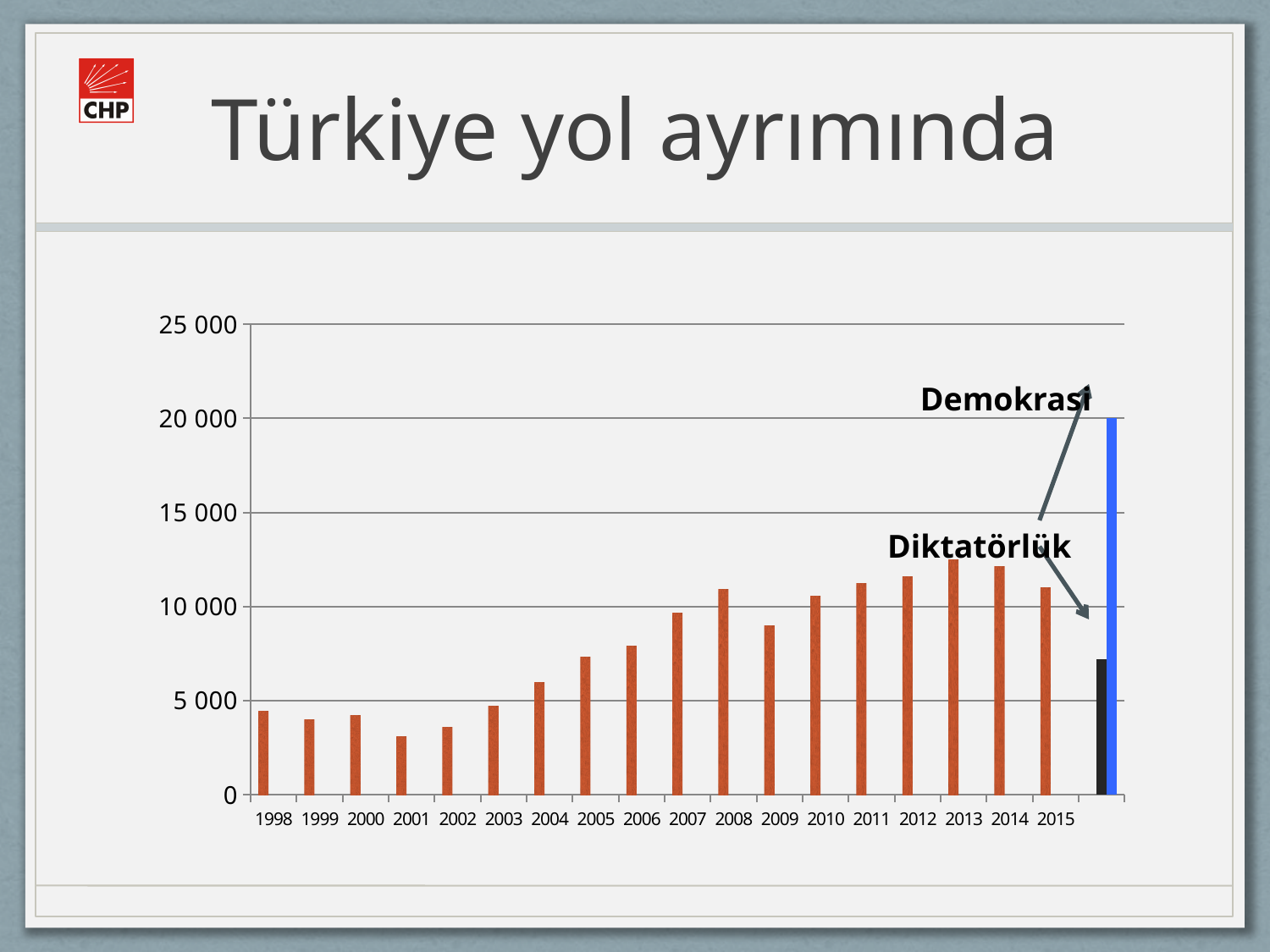
Is the value for 2013 greater or less than 10 000? greater What kind of chart is shown on the slide? bar chart Which labelled year has the lowest bar? 2001 Which labelled year has the highest bar? 2013 Which is larger, the bar for 2008 or the bar for 2009? 2008 Is the value for the Diktatörlük bar greater or less than 10 000? less How many years are labelled on the x axis? 18 What is the title of the slide containing the chart? Türkiye yol ayrımında Is the value for 1998 greater or less than 5 000? less What colour is the bar labelled Demokrasi? blue What value does the Demokrasi bar reach on the y axis? 20 000 Do the values generally rise or fall from 2001 to 2008? rise